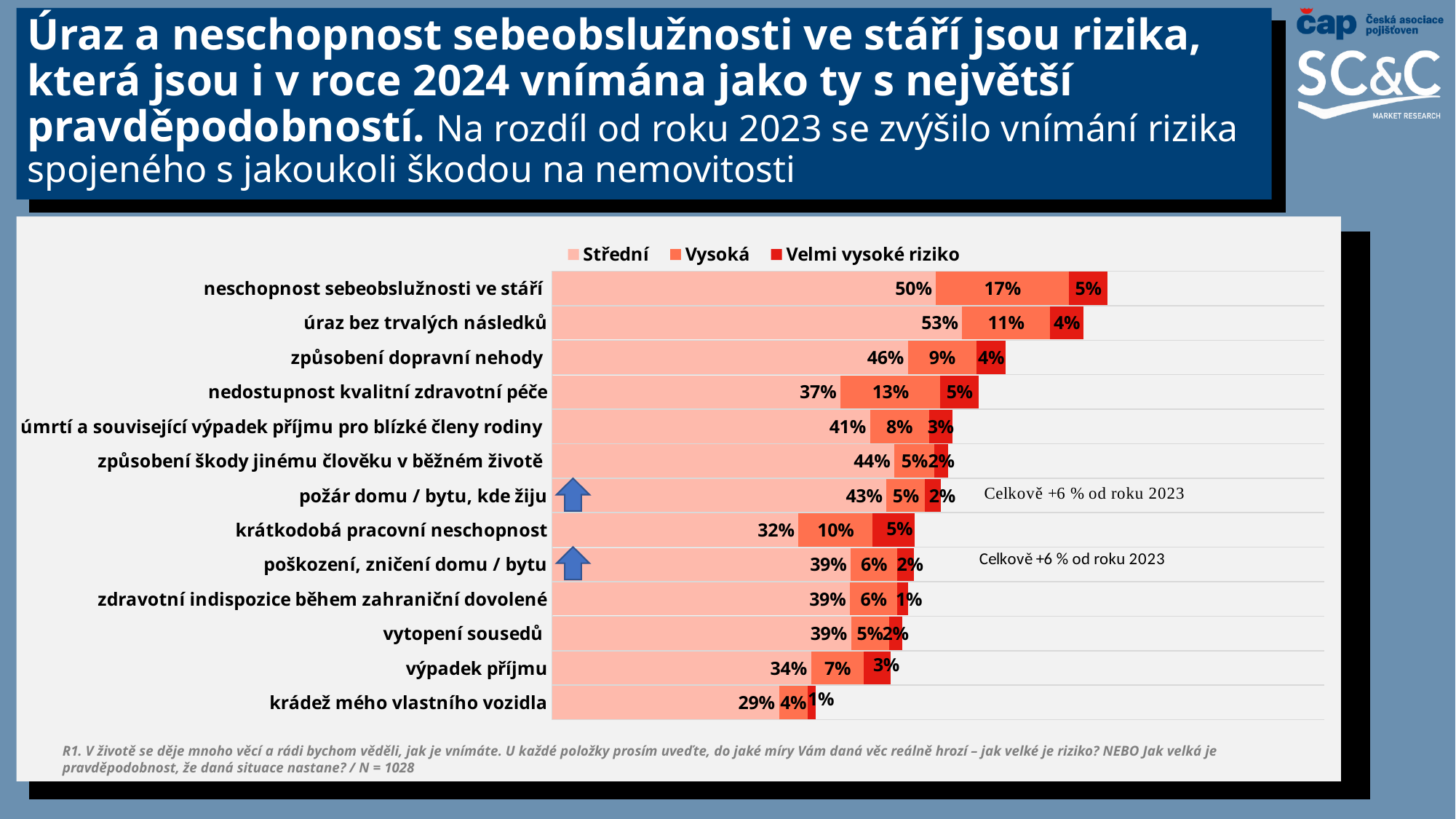
What is the Vysoká value for 'nedostupnost kvalitní zdravotní péče'? 13% What is the Střední value for 'neschopnost sebeobslužnosti ve stáří'? 50% Which category has the lowest Střední value? krádež mého vlastního vozidla How many categories are plotted in the chart? 13 What type of chart is shown on the slide? stacked bar chart What is the difference between the Vysoká values for 'neschopnost sebeobslužnosti ve stáří' and 'úraz bez trvalých následků'? 6% Which legend entry is shown in the darkest red colour? Velmi vysoké riziko Which category has the highest Střední value? úraz bez trvalých následků What is the total of the stacked bar for 'neschopnost sebeobslužnosti ve stáří'? 72% Which is larger, the Střední value for 'způsobení dopravní nehody' or for 'krátkodobá pracovní neschopnost'? způsobení dopravní nehody How many series does the legend list? 3 What is the Velmi vysoké riziko value for 'úraz bez trvalých následků'? 4%